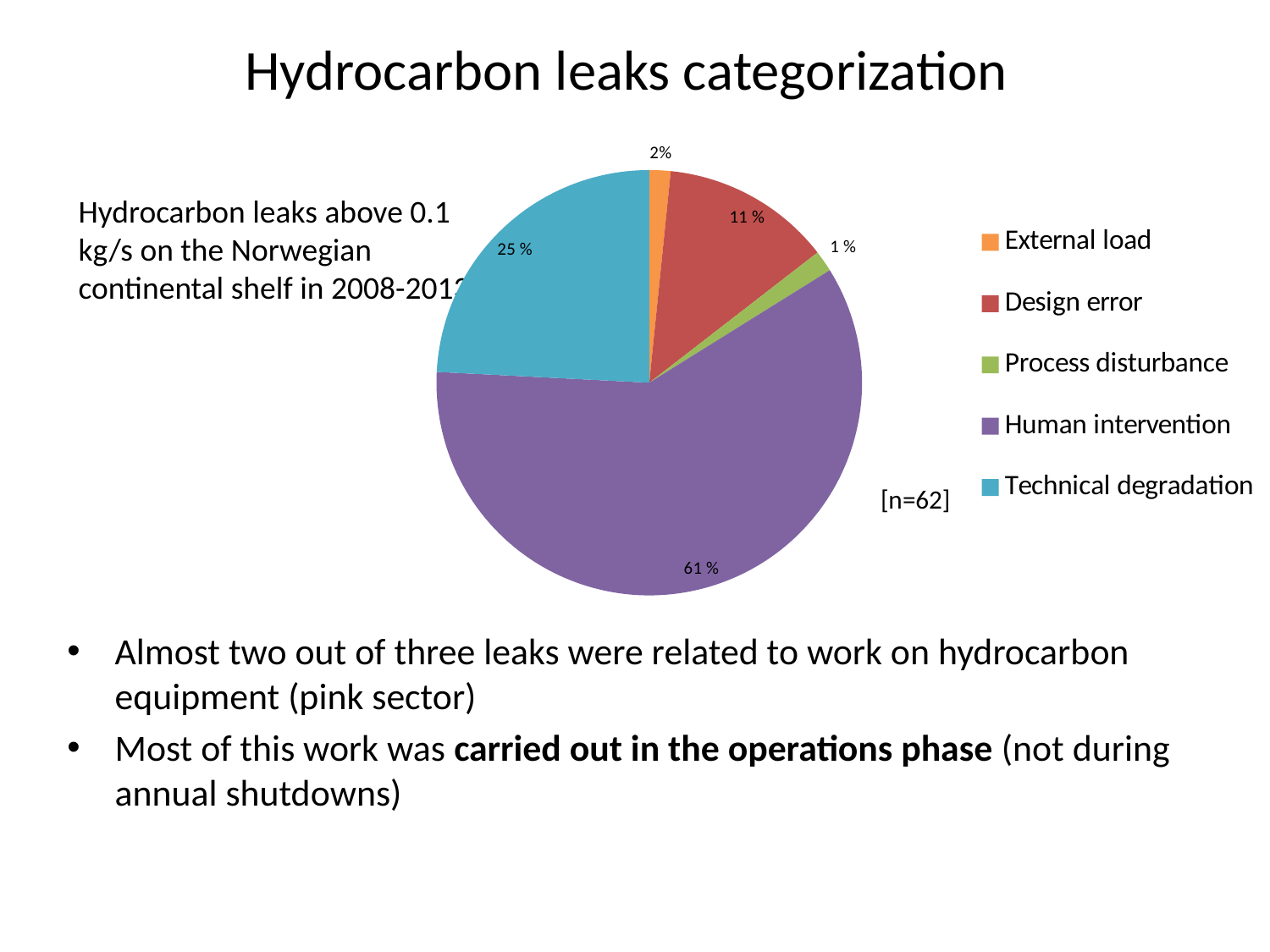
What percentage is shown for Design error? 11 % What share of the pie does Human intervention account for? 61 % What type of chart is shown on the slide? pie chart What sample size (n) is noted next to the pie chart? n=62 What is the difference in percentage points between Human intervention and Technical degradation? 36 How many categories does the legend list? 5 Which is larger, the share for Design error or the share for Technical degradation? Technical degradation What percentage is shown for Technical degradation? 25 % What percentage is shown for External load? 2% Which category has the largest slice of the pie? Human intervention What percentage is shown for Process disturbance? 1 %